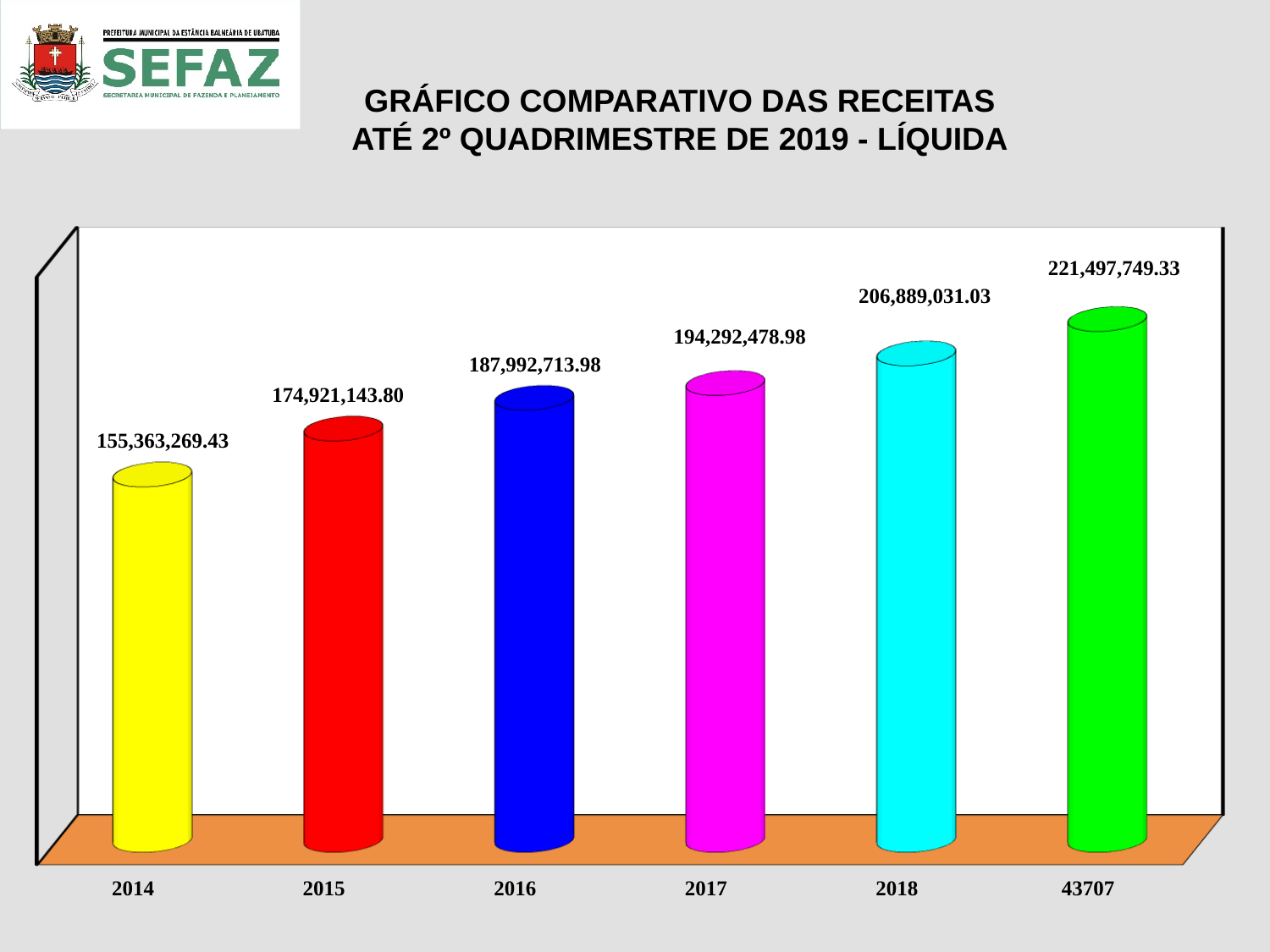
Which is larger, the value for 2017 or the value for 2016? 2017 What is the value shown for 2014? 155,363,269.43 What kind of chart is shown on the slide? Bar chart What is the difference between the values for 2015 and 2014? 19,557,874.37 What is the value shown for 2016? 187,992,713.98 How many categories are plotted on the chart? 6 What is the value shown for 2018? 206,889,031.03 Which category has the highest value? 43707 Do the values rise or fall from left to right along the x axis? Rise What is the difference between the values for 2018 and 2017? 12,596,552.05 What is the value shown for the last category, labelled 43707? 221,497,749.33 Which category has the lowest value? 2014